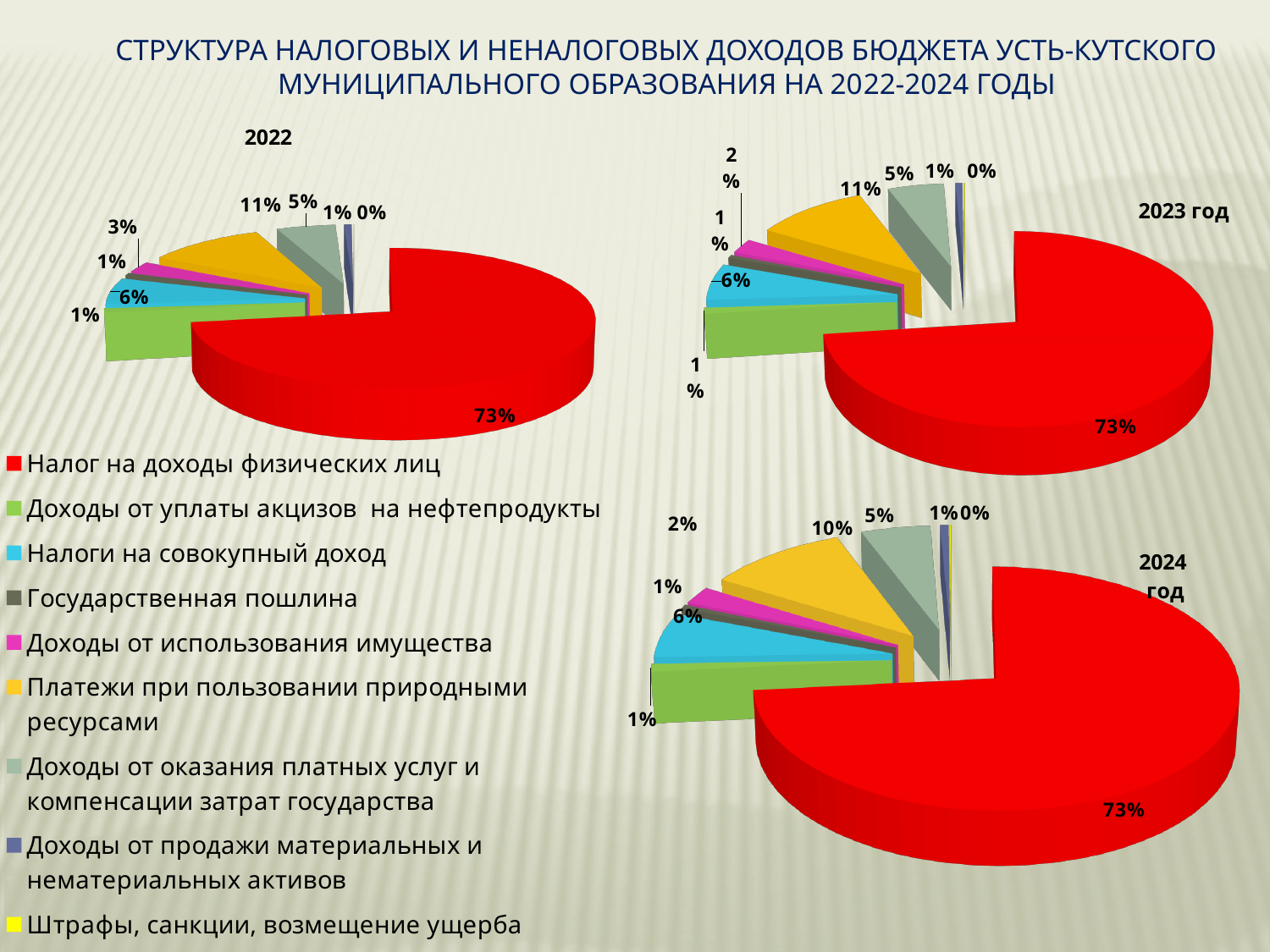
In the 2024 год pie chart, which is larger: Налоги на совокупный доход or Доходы от оказания платных услуг и компенсации затрат государства? Налоги на совокупный доход In the 2023 год pie chart, which category has the largest share? Налог на доходы физических лиц In the 2022 pie chart, what share is shown for Налог на доходы физических лиц? 73% In the 2023 год pie chart, what share is shown for Доходы от использования имущества? 2% In the 2022 pie chart, what share is shown for Платежи при пользовании природными ресурсами? 11% In the 2022 pie chart, what is the difference in percentage points between Платежи при пользовании природными ресурсами and Доходы от оказания платных услуг и компенсации затрат государства? 6 percentage points What type of chart is used on this slide? Pie chart In the 2022 pie chart, what share is shown for Доходы от использования имущества? 3% In the 2024 год pie chart, what share is shown for Платежи при пользовании природными ресурсами? 10% How many pie charts are shown on the slide? 3 How many categories does the legend list? 9 In the 2024 год pie chart, what share is shown for Штрафы, санкции, возмещение ущерба? 0%